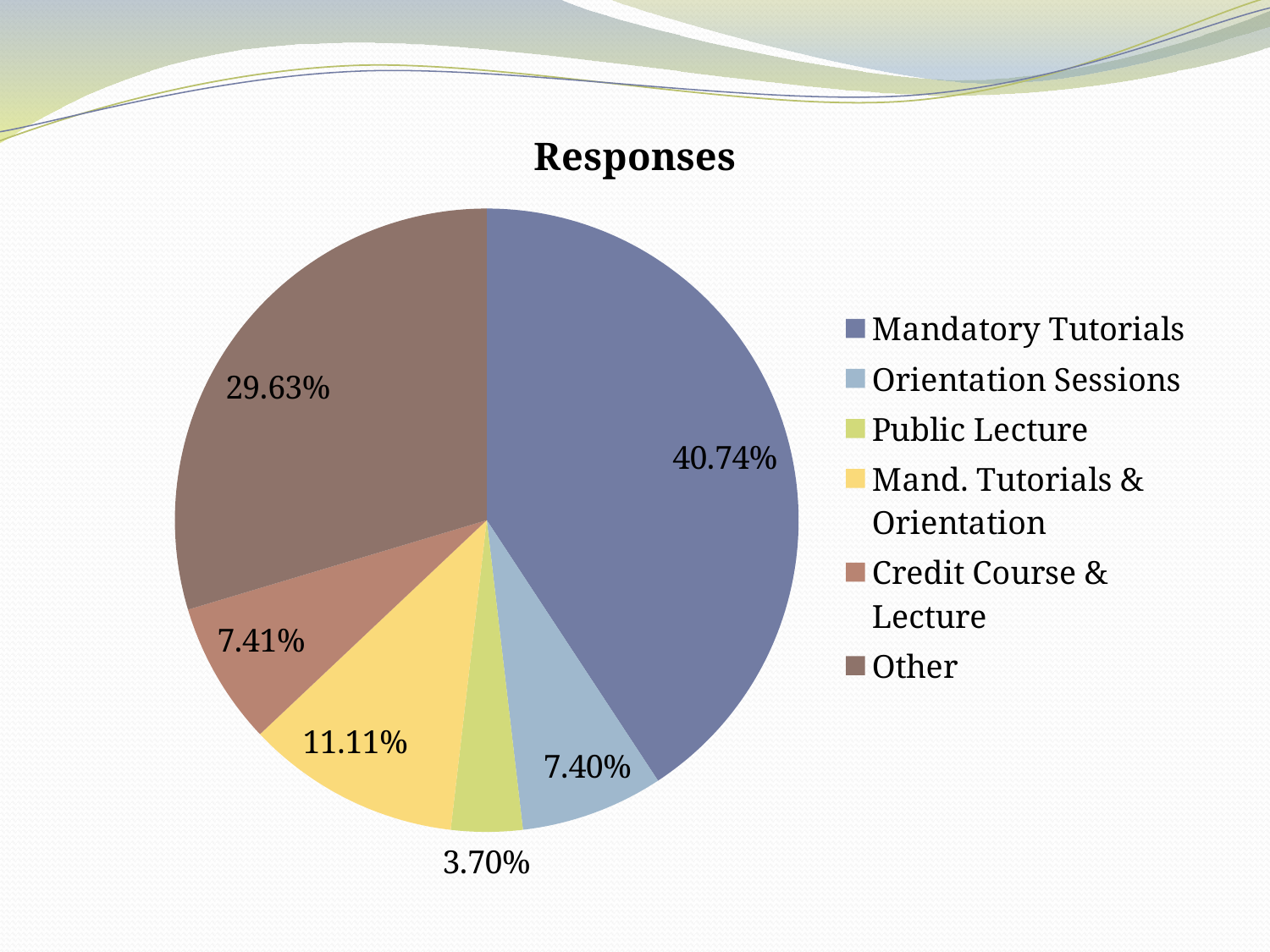
What percentage of responses is Mandatory Tutorials? 40.74% Which category has the smallest share of responses? Public Lecture What percentage of responses is Orientation Sessions? 7.40% What is the difference between the Mandatory Tutorials share and the Other share? 11.11% Which category has the largest share of responses? Mandatory Tutorials What percentage of responses is Public Lecture? 3.70% What percentage of responses is Mand. Tutorials & Orientation? 11.11% What percentage of responses is Other? 29.63% How many categories does the legend list? 6 Which is larger, the share for Mand. Tutorials & Orientation or the share for Public Lecture? Mand. Tutorials & Orientation What is the title of the chart? Responses What type of chart is shown on the slide? Pie chart